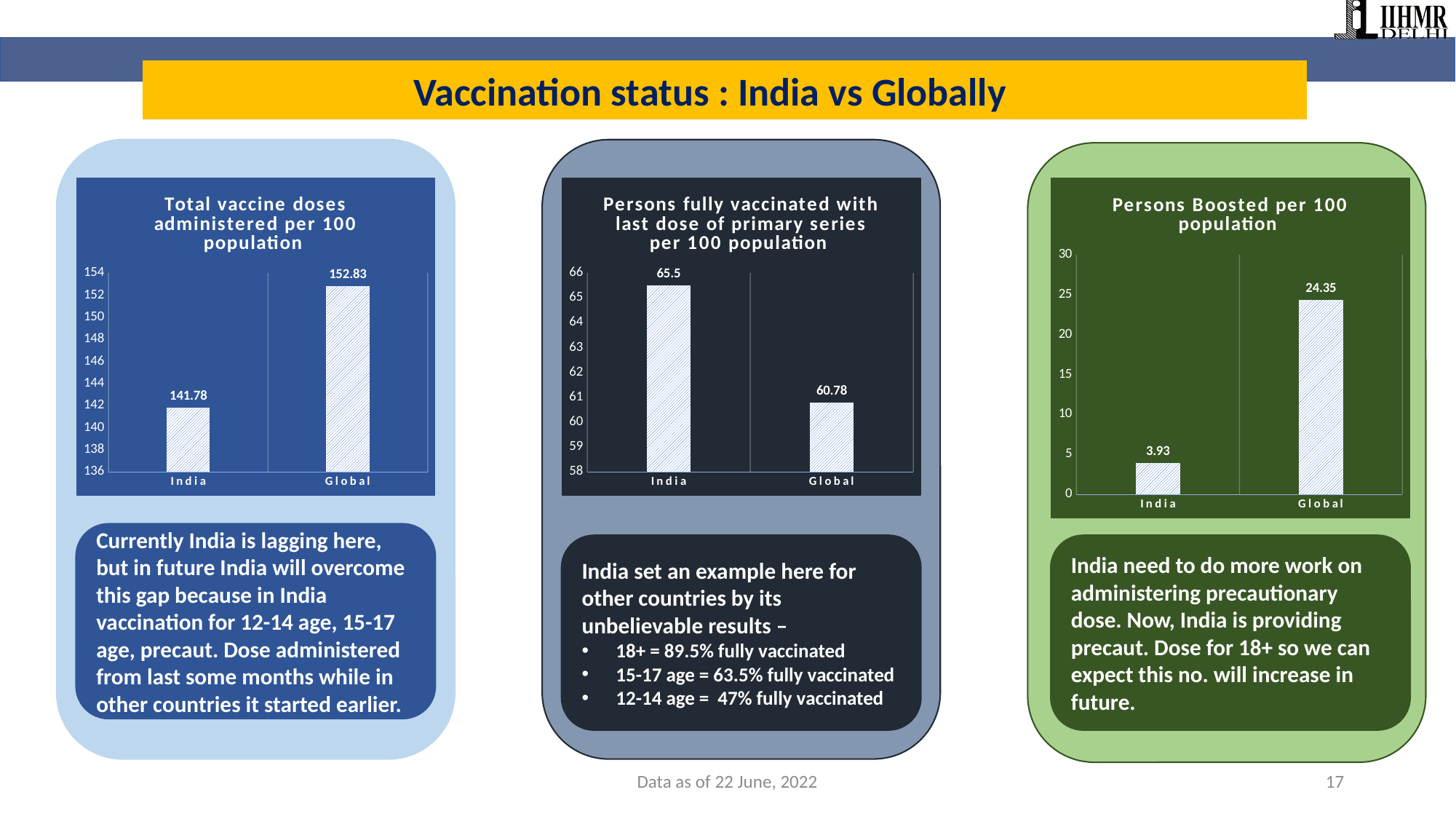
In the 'Persons Boosted per 100 population' chart, what is the difference between the Global and India values? 20.42 What type of chart is the 'Persons Boosted per 100 population' chart? Bar chart In the 'Persons Boosted per 100 population' chart, what is the value for India? 3.93 In the 'Persons Boosted per 100 population' chart, which category has the lowest value? India How many categories are shown in the 'Total vaccine doses administered per 100 population' chart? 2 In the 'Persons fully vaccinated with last dose of primary series per 100 population' chart, which category is higher, India or Global? India In the 'Total vaccine doses administered per 100 population' chart, what is the difference between the Global and India values? 11.05 In the 'Total vaccine doses administered per 100 population' chart, what is the value for Global? 152.83 In the 'Persons fully vaccinated with last dose of primary series per 100 population' chart, what is the value for India? 65.5 In the 'Persons Boosted per 100 population' chart, what is the value for Global? 24.35 In the 'Persons fully vaccinated with last dose of primary series per 100 population' chart, what is the difference between the India and Global values? 4.72 In the 'Total vaccine doses administered per 100 population' chart, what is the value for India? 141.78